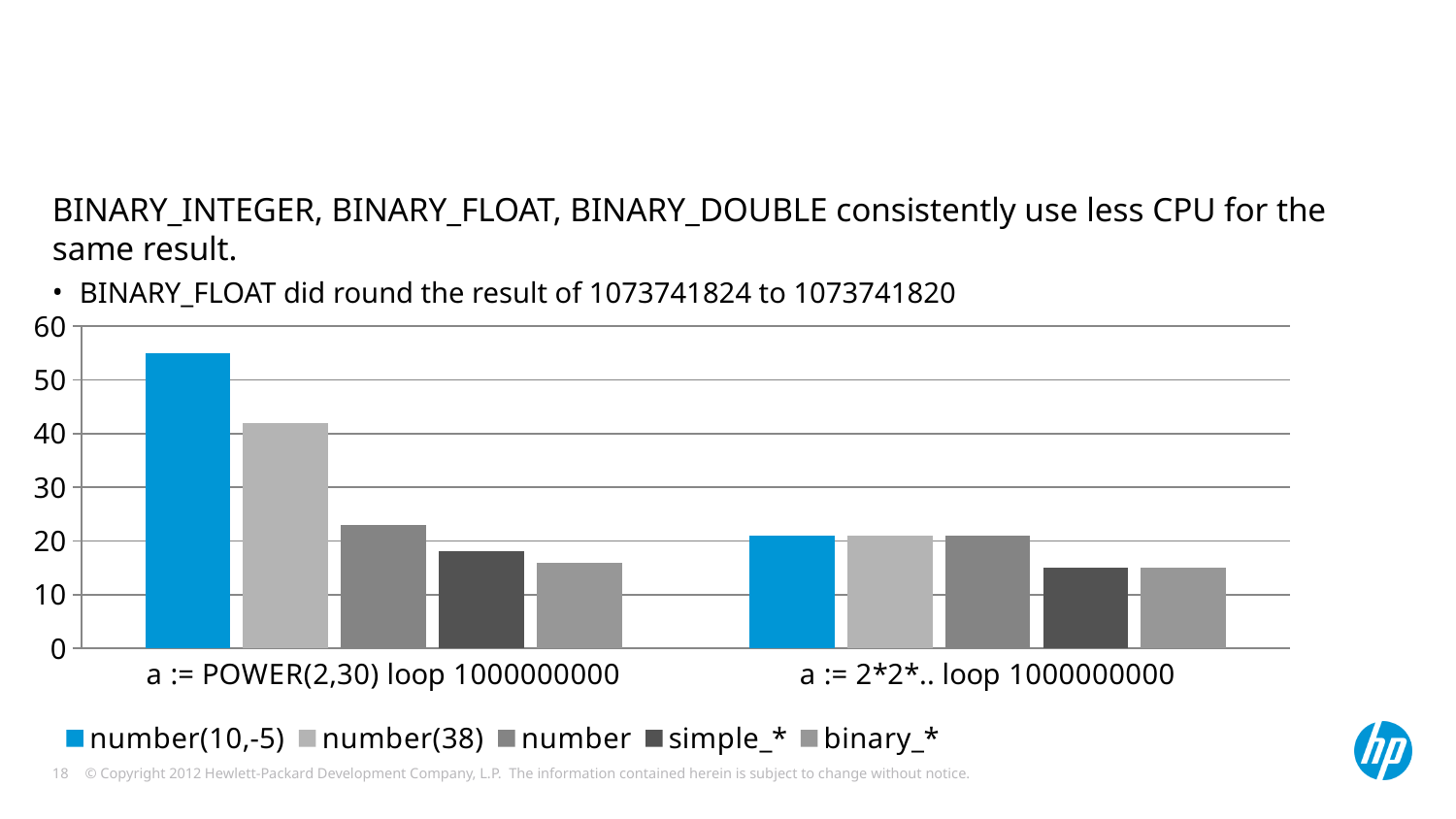
How many series does the legend list? 5 Is the value for binary_* in the category "a := 2*2*.. loop 1000000000" greater or less than 20? less Which is larger in the category "a := POWER(2,30) loop 1000000000": number(38) or simple_*? number(38) Is the value for number(38) in the category "a := POWER(2,30) loop 1000000000" greater or less than 40? greater What is the first series listed in the legend? number(10,-5) How many categories are shown on the x axis? 2 Which series has the highest value for the category "a := POWER(2,30) loop 1000000000"? number(10,-5) Is the value for number(10,-5) in the category "a := POWER(2,30) loop 1000000000" greater or less than 50? greater Which is larger: the value for number(10,-5) in "a := POWER(2,30) loop 1000000000" or in "a := 2*2*.. loop 1000000000"? a := POWER(2,30) loop 1000000000 What kind of chart is shown on the slide? bar chart Which series has the lowest value for the category "a := POWER(2,30) loop 1000000000"? binary_*